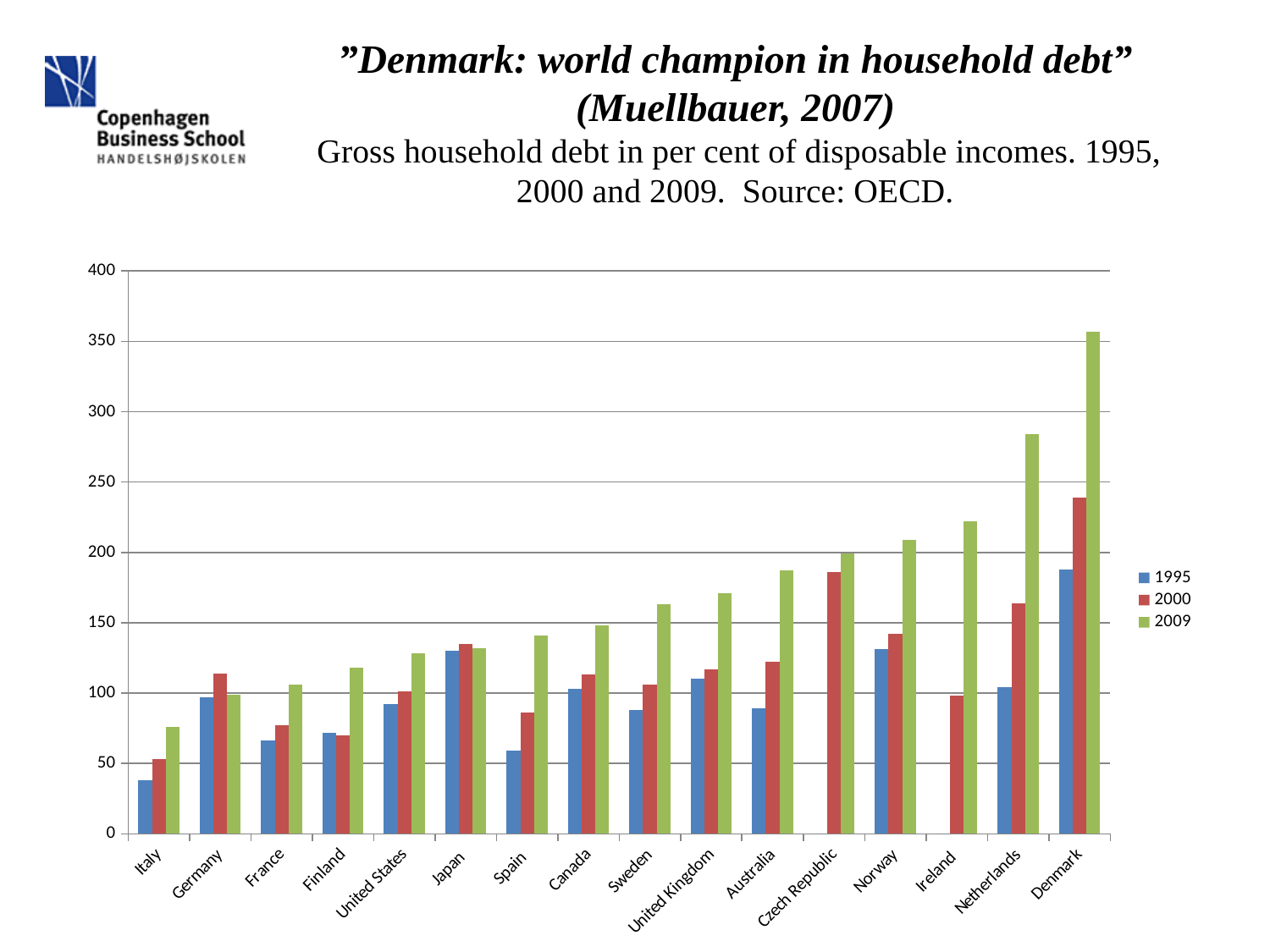
Which country has the lowest value for 2009? Italy Is the value for Netherlands in 2009 greater or less than 300? less Which colour represents the 2009 series in the legend? green Which country has the highest value for 2009? Denmark How many series does the legend list? 3 What kind of chart is shown on the slide? bar chart Is the value for Italy in 1995 greater or less than 50? less Is the value for Ireland in 2009 greater or less than 200? greater For Germany, which is larger: the value for 2000 or the value for 2009? 2000 How many countries are shown on the x axis? 16